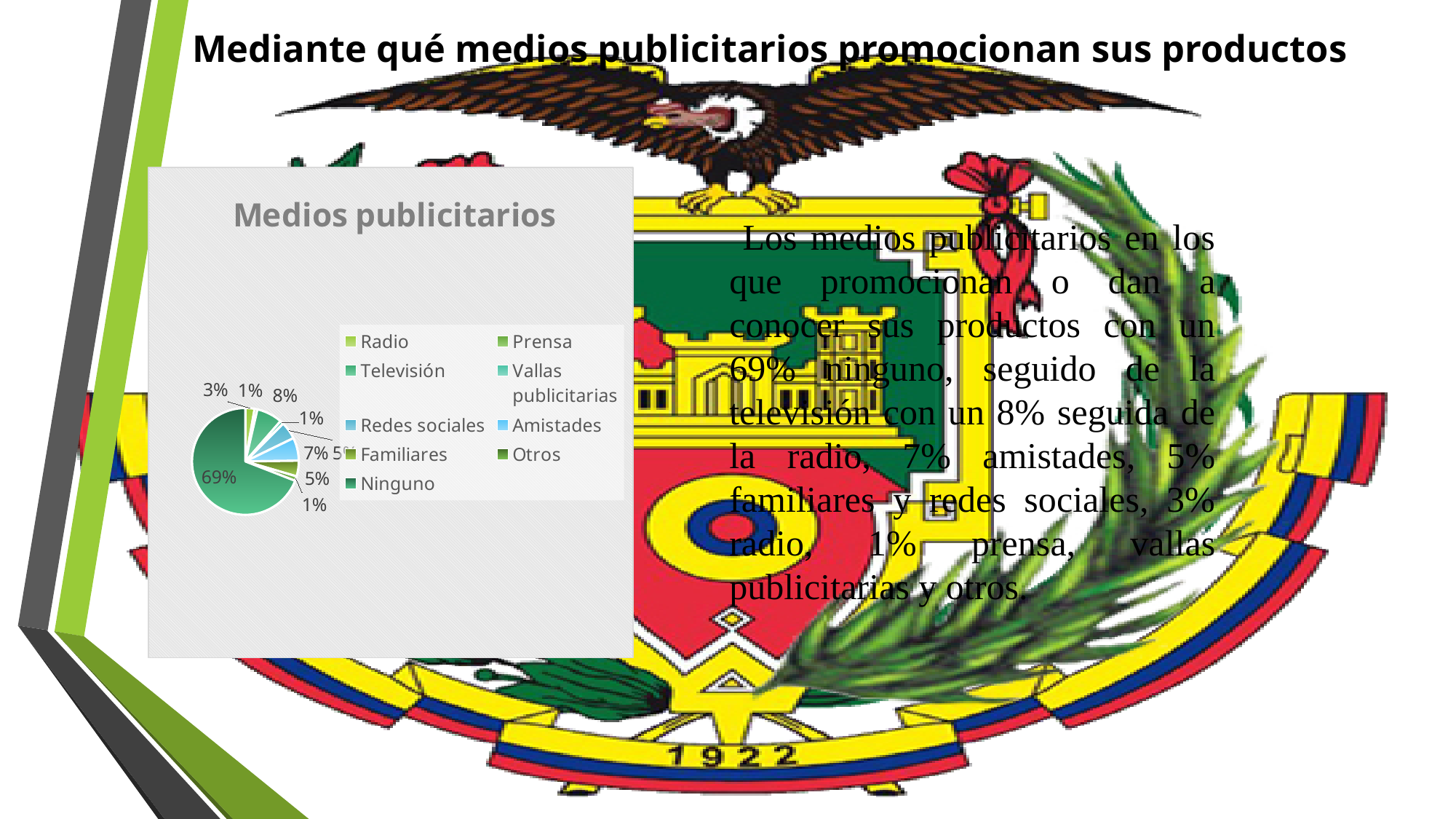
In the "Medios publicitarios" chart, what is the difference between the Ninguno share and the Televisión share? 61% What percentage is shown for Amistades in the "Medios publicitarios" chart? 7% In the "Medios publicitarios" chart, what percentage is shown for Prensa? 1% Which category has the largest slice in the "Medios publicitarios" pie chart? Ninguno What percentage is shown for Radio in the "Medios publicitarios" chart? 3% What share of the "Medios publicitarios" pie does Ninguno represent? 69% In the "Medios publicitarios" chart, which is larger: Televisión or Amistades? Televisión What percentage is shown for Familiares in the "Medios publicitarios" chart? 5% What kind of chart is shown under the title "Medios publicitarios"? pie chart What is the title of the chart on the slide? Medios publicitarios What percentage is shown for Televisión in the "Medios publicitarios" chart? 8% How many entries does the legend of the "Medios publicitarios" chart list? 9